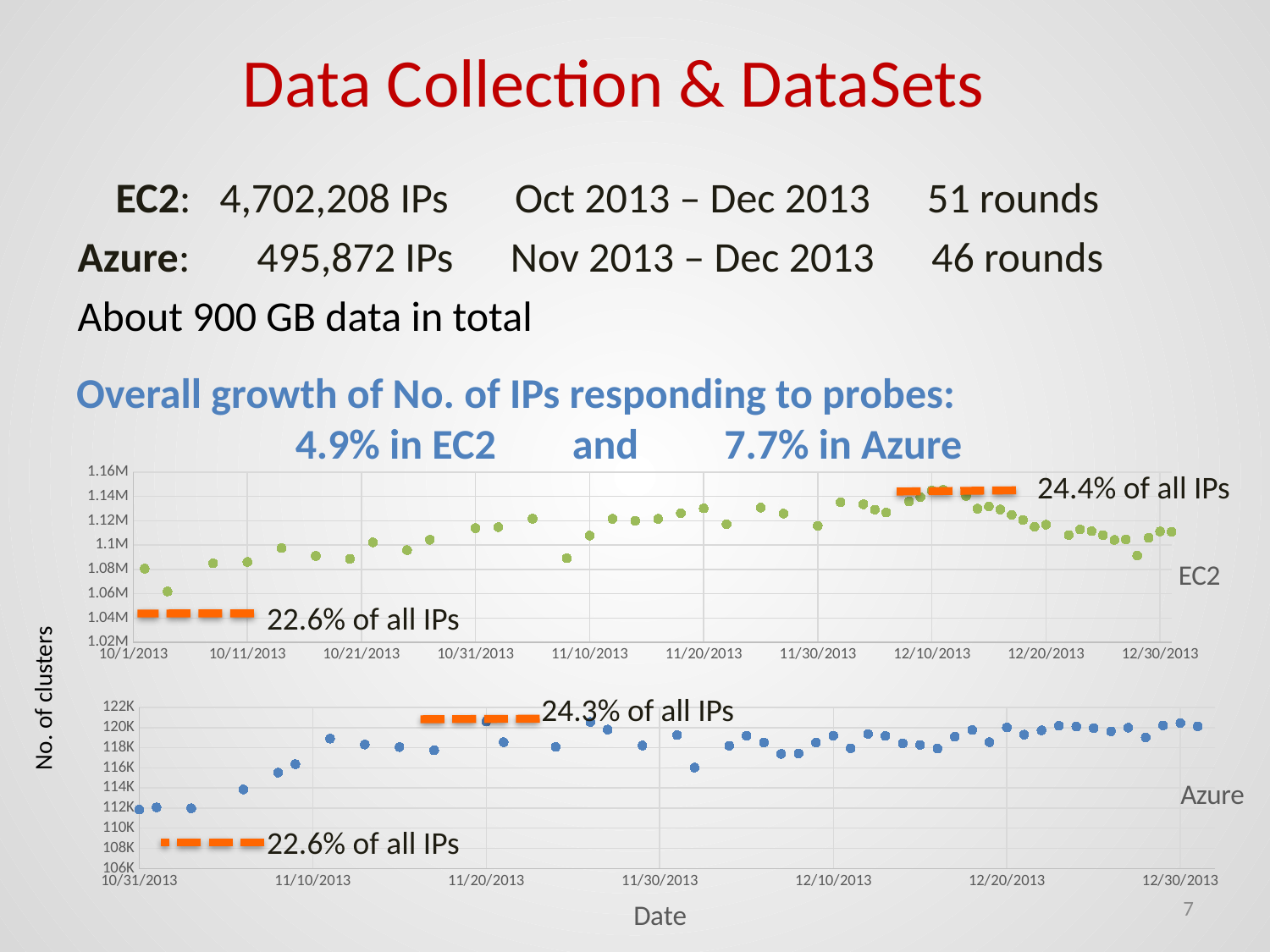
What percentage of all IPs is annotated at the end of the top (EC2) chart? 24.4% of all IPs In the bottom (Azure) chart, is the value at 10/31/2013 greater or less than 110K? greater What kind of chart is the top (EC2) chart? scatter chart In the top (EC2) chart, do the values generally rise or fall from 10/1/2013 to 12/30/2013? rise In the bottom (Azure) chart, are the values around 12/30/2013 greater or less than 118K? greater What kind of chart is the bottom (Azure) chart? scatter chart In the top (EC2) chart, are the values around 12/10/2013 greater or less than 1.12M? greater In the bottom (Azure) chart, do the values generally rise or fall from 10/31/2013 to 12/30/2013? rise How many charts are shown on the slide? 2 What percentage of all IPs is annotated at the end of the bottom (Azure) chart? 24.3% of all IPs